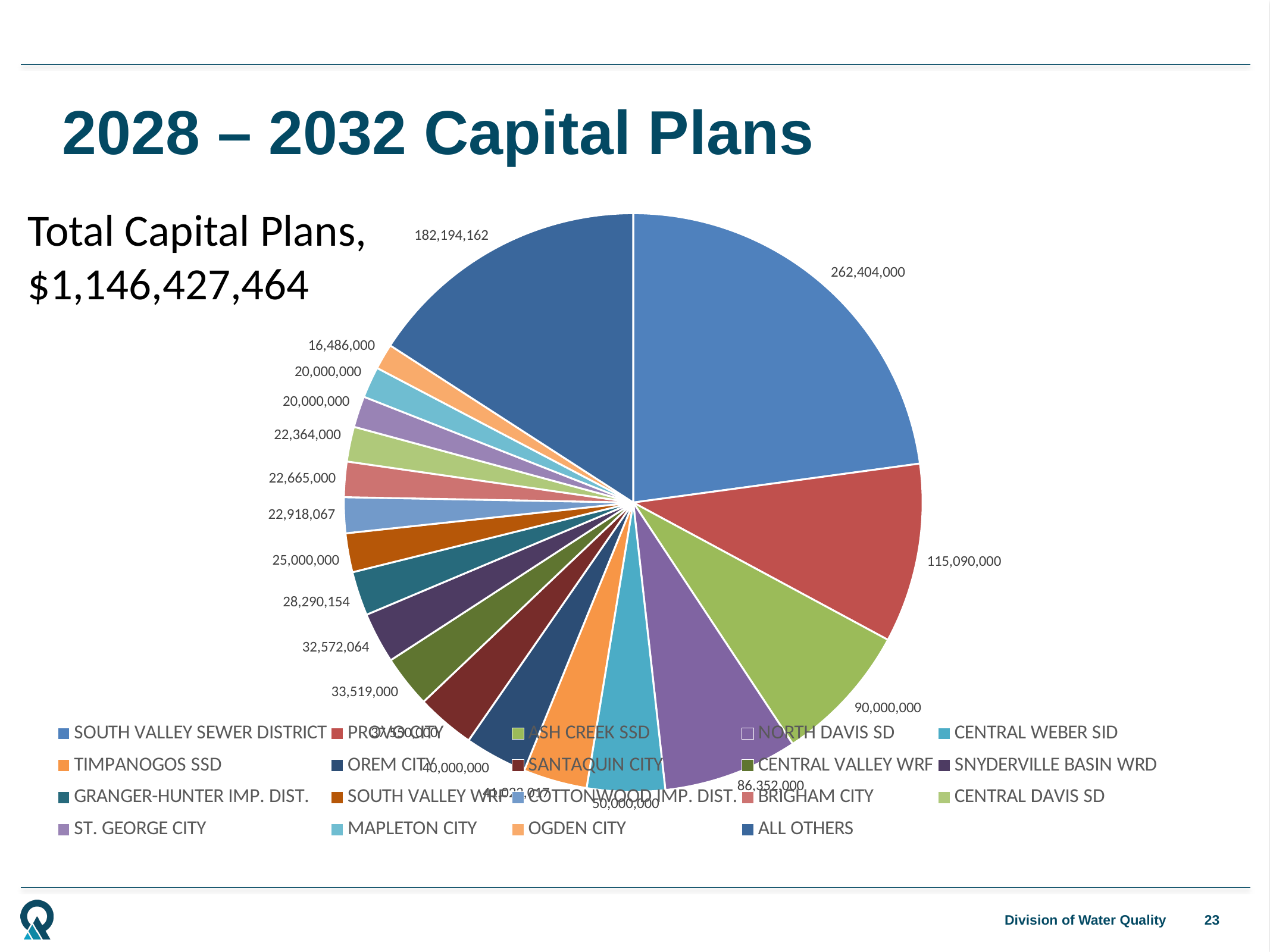
How many entries does the legend list? 19 Which named entity has the largest slice of the pie? SOUTH VALLEY SEWER DISTRICT What is the difference between the values for SOUTH VALLEY SEWER DISTRICT and PROVO CITY? 147,314,000 What kind of chart is shown on the slide? pie chart What is the value for PROVO CITY? 115,090,000 Which entity has the smallest slice of the pie? OGDEN CITY Which is larger, the value for ASH CREEK SSD or NORTH DAVIS SD? ASH CREEK SSD What is the value for GRANGER-HUNTER IMP. DIST.? 28,290,154 What is the value for CENTRAL WEBER SID? 50,000,000 What total capital plans amount is stated on the slide? $1,146,427,464 What is the value for SOUTH VALLEY SEWER DISTRICT? 262,404,000 What is the value for ALL OTHERS? 182,194,162